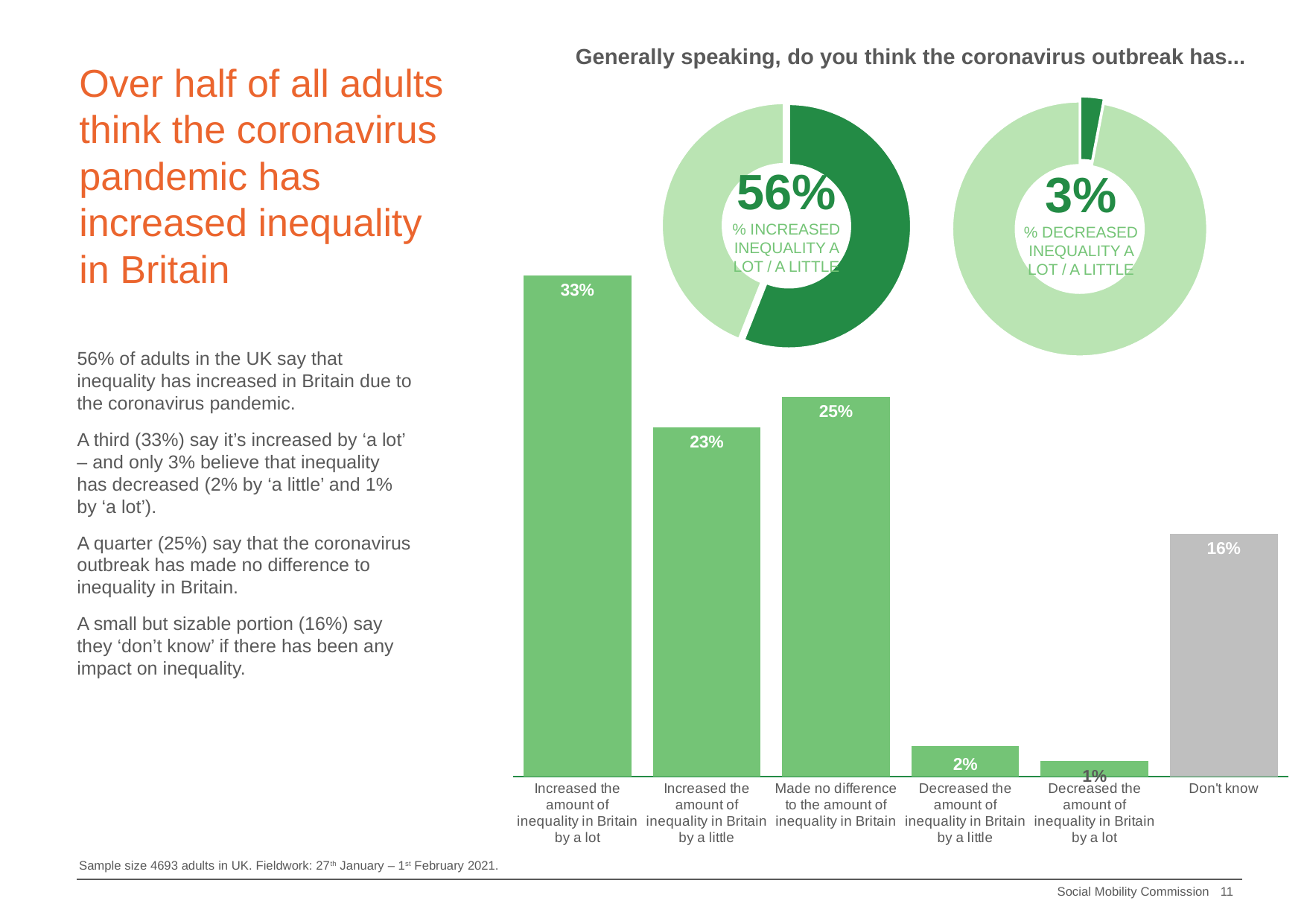
In the bar chart, which category has the lowest value? Decreased the amount of inequality in Britain by a lot In the bar chart, what percentage of adults said the coronavirus outbreak increased the amount of inequality in Britain by a lot? 33% In the bar chart, what is the difference between 'Increased the amount of inequality in Britain by a lot' and 'Increased the amount of inequality in Britain by a little'? 10% In the right donut chart, what percentage of adults said the coronavirus outbreak decreased inequality a lot or a little? 3% What type of chart is the chart at the bottom right of the slide showing the six response categories? Bar chart In the bar chart, what is the value for 'Made no difference to the amount of inequality in Britain'? 25% What is the title shown above the charts on the slide? Generally speaking, do you think the coronavirus outbreak has... In the bar chart, which is larger: 'Made no difference to the amount of inequality in Britain' or 'Increased the amount of inequality in Britain by a little'? Made no difference to the amount of inequality in Britain In the bar chart, which category has the highest value? Increased the amount of inequality in Britain by a lot How many categories are shown in the bar chart? 6 In the bar chart, what percentage answered 'Don't know'? 16% In the left donut chart, what percentage of adults said the coronavirus outbreak increased inequality a lot or a little? 56%